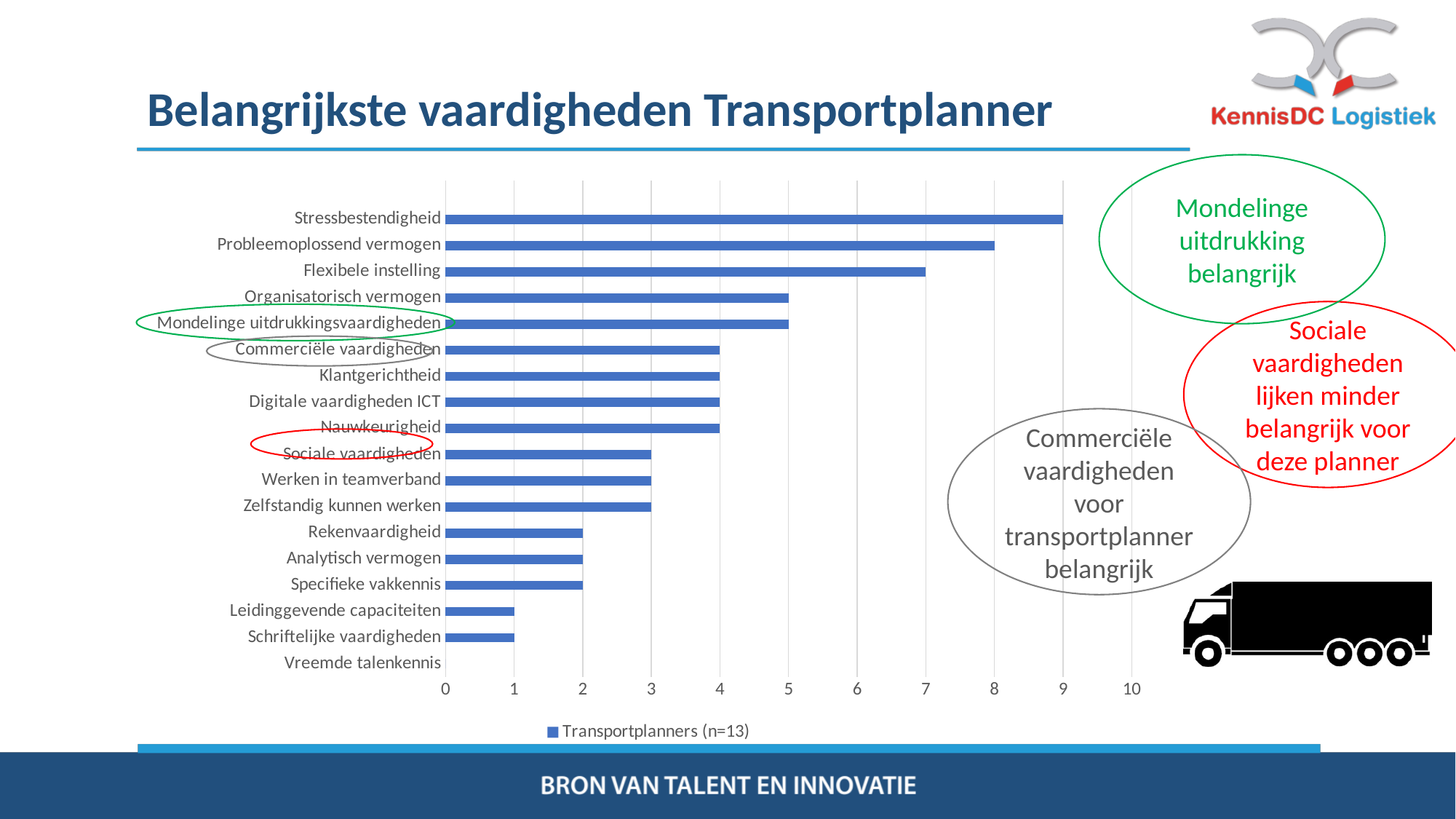
Which skill has the highest value in the chart? Stressbestendigheid What kind of chart is shown on the slide? bar chart What is the value for Flexibele instelling? 7 What is the difference between the values for Probleemoplossend vermogen and Rekenvaardigheid? 6 How many skill categories are listed on the chart? 18 Which skill has the lowest value in the chart? Vreemde talenkennis What is the value for Sociale vaardigheden? 3 What is the value for Stressbestendigheid? 9 How many series does the legend list? 1 Which is larger, the value for Organisatorisch vermogen or the value for Klantgerichtheid? Organisatorisch vermogen What is the legend entry of the chart? Transportplanners (n=13) Is the value for Probleemoplossend vermogen greater or less than 5? greater